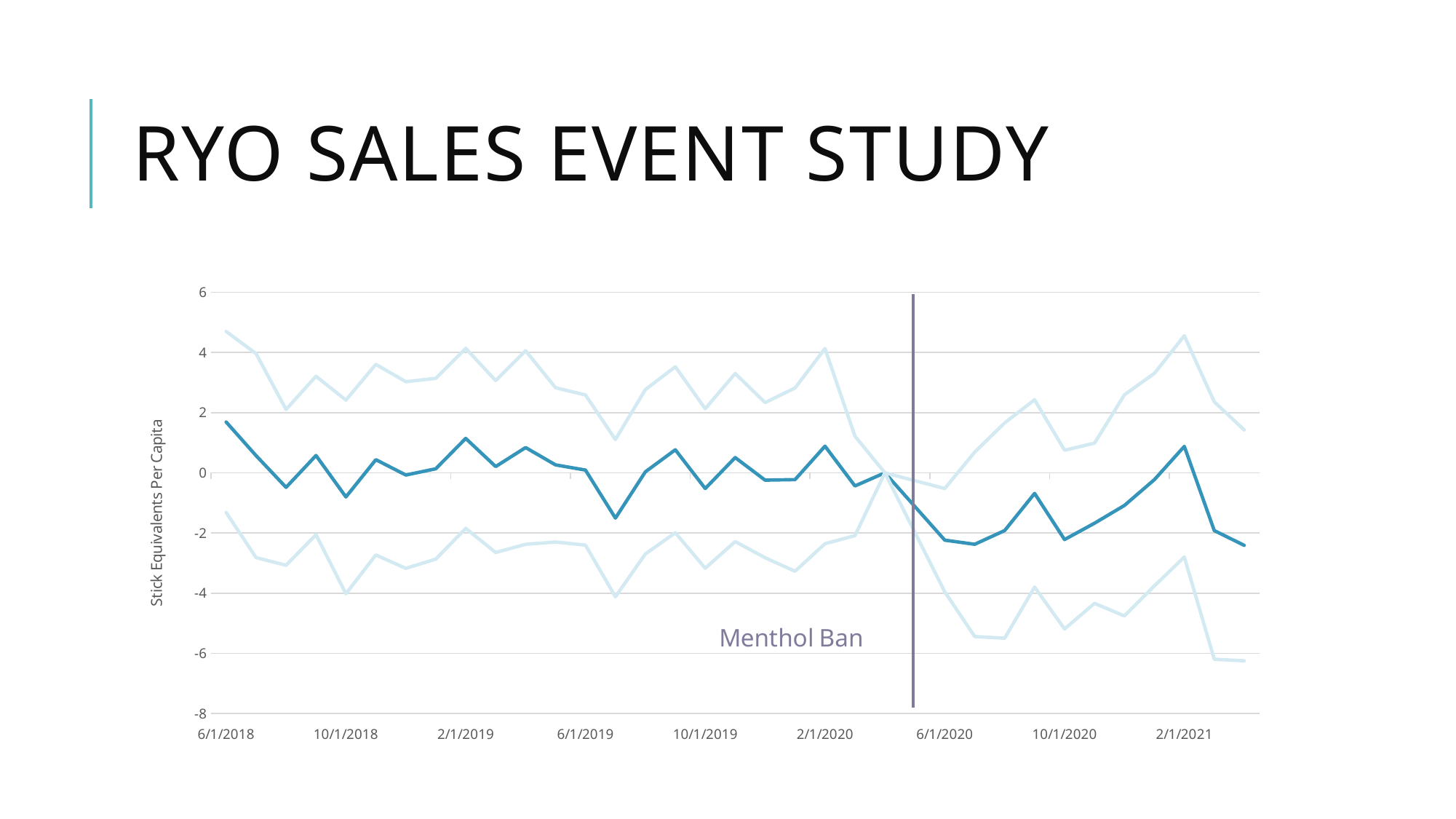
What kind of chart is shown on the slide? line chart What event does the vertical line on the chart mark? Menthol Ban Is the value of the dark blue line at 6/1/2020 greater or less than 0? less Does the dark blue line rise or fall immediately after the Menthol Ban line? fall Is the dark blue line higher at 6/1/2018 or at 6/1/2020? 6/1/2018 Is the value of the lower light blue line at 6/1/2018 greater or less than 0? less What is the title of the slide containing the chart? RYO Sales Event Study How many lines are plotted on the chart? 3 Is the value of the dark blue line at 6/1/2018 greater or less than 0? greater What is the label on the vertical axis of the chart? Stick Equivalents Per Capita